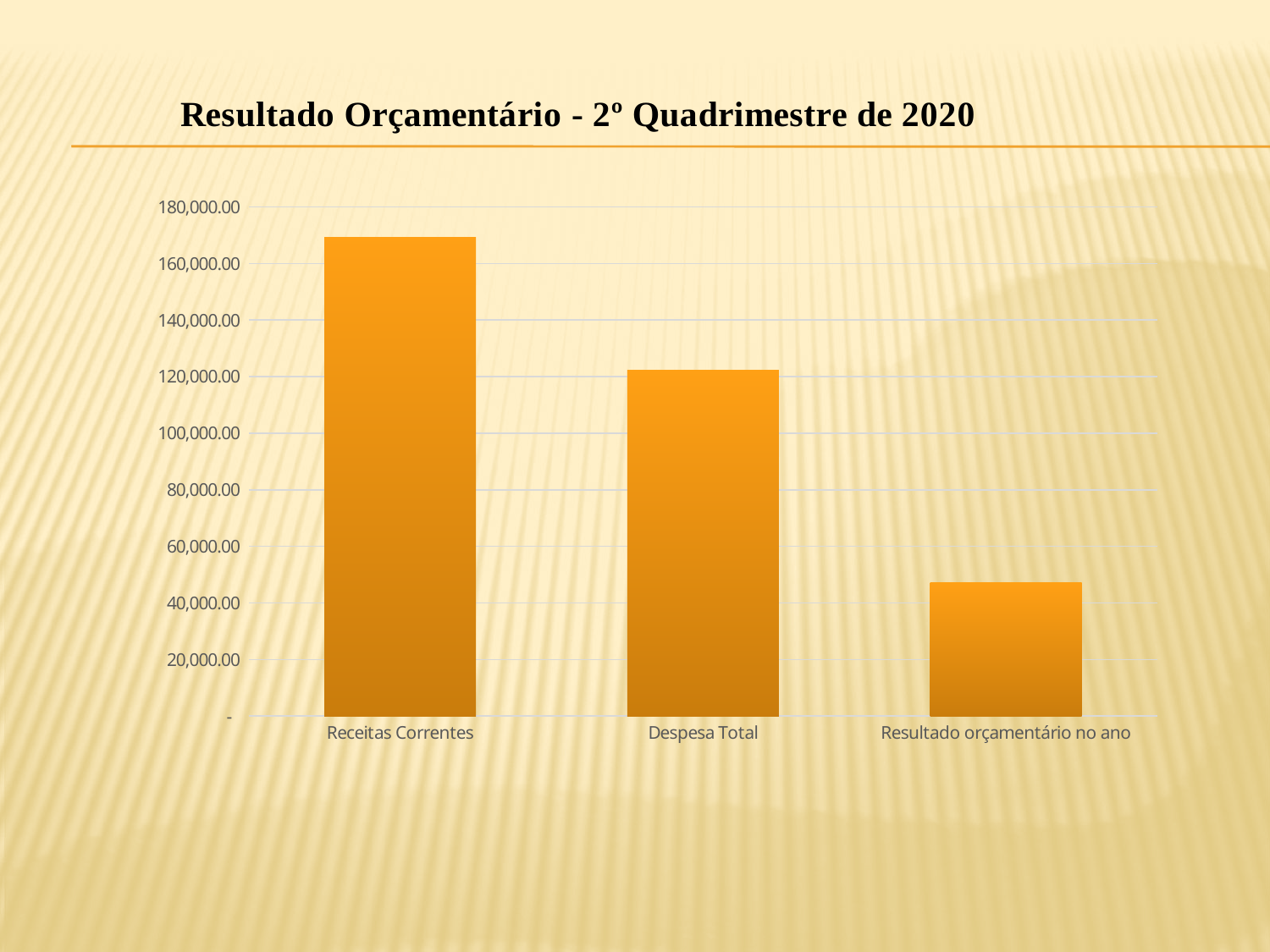
Which category has the lowest bar? Resultado orçamentário no ano What kind of chart is shown on the slide? bar chart Which category has the highest bar? Receitas Correntes What is the title of the slide containing the chart? Resultado Orçamentário - 2º Quadrimestre de 2020 Which is larger, Receitas Correntes or Despesa Total? Receitas Correntes Do the bar values rise or fall from left to right across the categories? fall Which is larger, Despesa Total or Resultado orçamentário no ano? Despesa Total Is the value for Despesa Total greater or less than 140,000.00? less Is the value for Receitas Correntes greater or less than 160,000.00? greater Is the value for Resultado orçamentário no ano greater or less than 60,000.00? less How many categories are shown on the x axis of the chart? 3